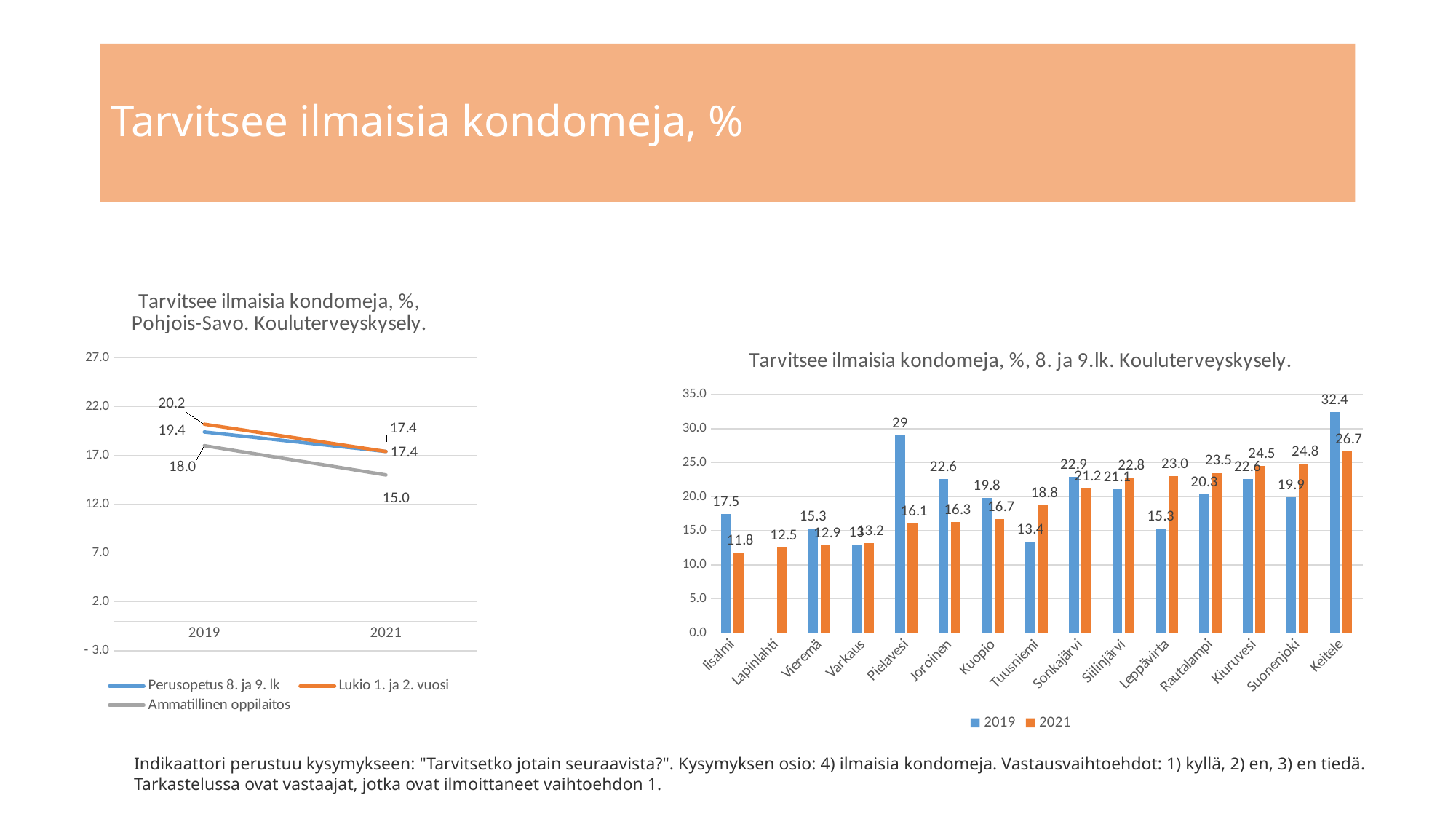
In the right chart (8. ja 9.lk), what is the 2021 value for Suonenjoki? 24.8 In the right chart (8. ja 9.lk), which municipality has the highest 2019 value? Keitele In the right chart (8. ja 9.lk), how many municipalities are shown on the x axis? 15 In the left chart (Pohjois-Savo), how many series does the legend list? 3 In the left chart (Pohjois-Savo), does the Perusopetus 8. ja 9. lk line rise or fall from 2019 to 2021? fall In the left chart (Pohjois-Savo), what is the difference between the Ammatillinen oppilaitos values in 2019 and 2021? 3.0 In the right chart (8. ja 9.lk), which is larger for Tuusniemi, the 2019 value or the 2021 value? 2021 In the left chart (Pohjois-Savo), what is the value for Lukio 1. ja 2. vuosi in 2019? 20.2 In the right chart (8. ja 9.lk), which municipality has the lowest 2021 value? Iisalmi In the left chart (Pohjois-Savo), what is the value for Ammatillinen oppilaitos in 2021? 15.0 What kind of chart is the right chart (8. ja 9.lk)? bar chart In the right chart (8. ja 9.lk), what is the 2019 value for Pielavesi? 29